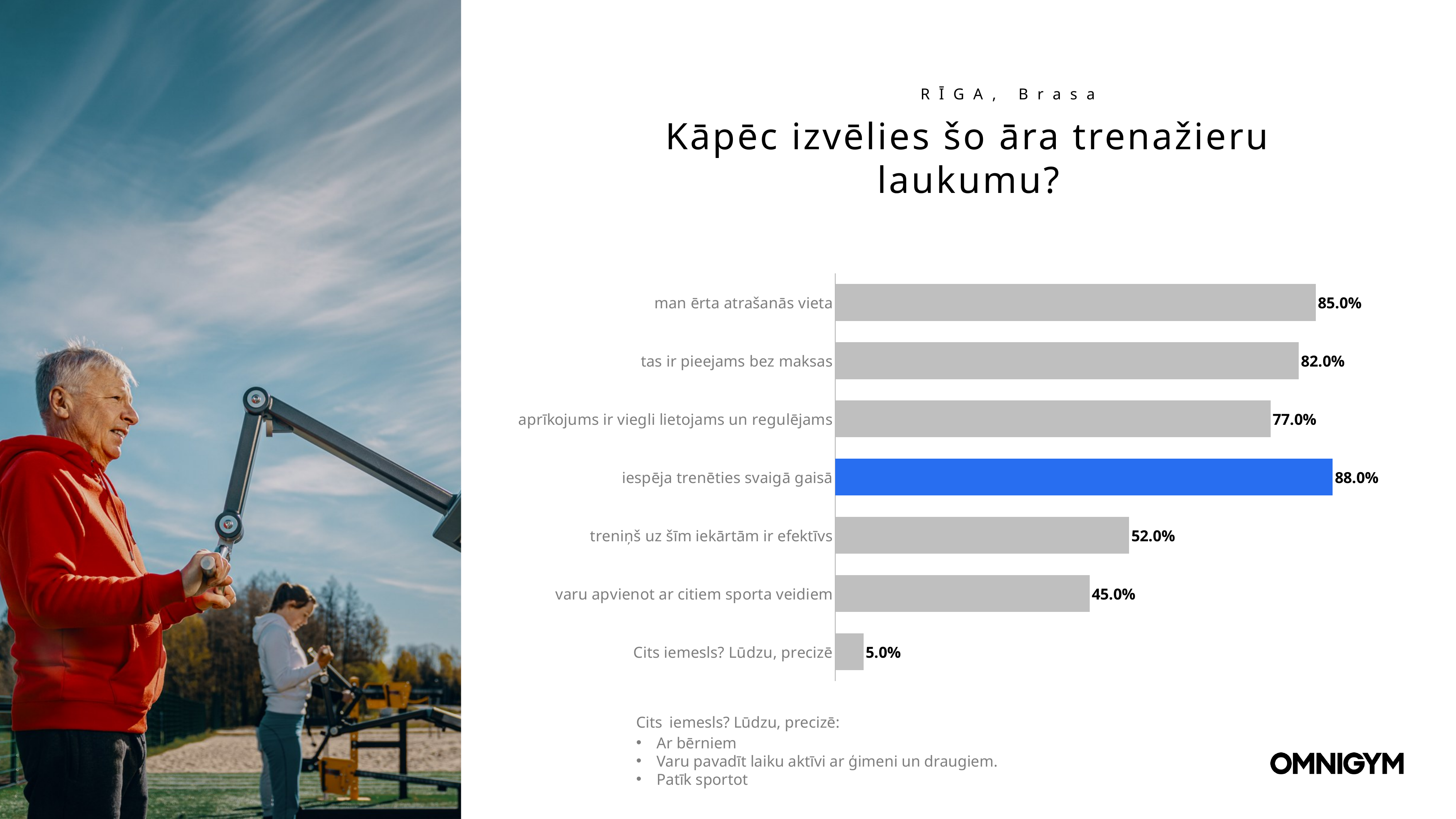
What kind of chart is shown on the slide? bar chart What is the title of the chart? Kāpēc izvēlies šo āra trenažieru laukumu? Which bar is highlighted in blue? iespēja trenēties svaigā gaisā What is the value for "tas ir pieejams bez maksas"? 82.0% Which category has the lowest value? Cits iemesls? Lūdzu, precizē Which is larger: the value for "tas ir pieejams bez maksas" or the value for "treniņš uz šīm iekārtām ir efektīvs"? tas ir pieejams bez maksas How many categories does the chart show? 7 What is the value for "varu apvienot ar citiem sporta veidiem"? 45.0% What is the difference between the values for "man ērta atrašanās vieta" and "aprīkojums ir viegli lietojams un regulējams"? 8.0% What is the difference between the values for "treniņš uz šīm iekārtām ir efektīvs" and "varu apvienot ar citiem sporta veidiem"? 7.0% Which category has the highest value? iespēja trenēties svaigā gaisā What is the value for "iespēja trenēties svaigā gaisā"? 88.0%